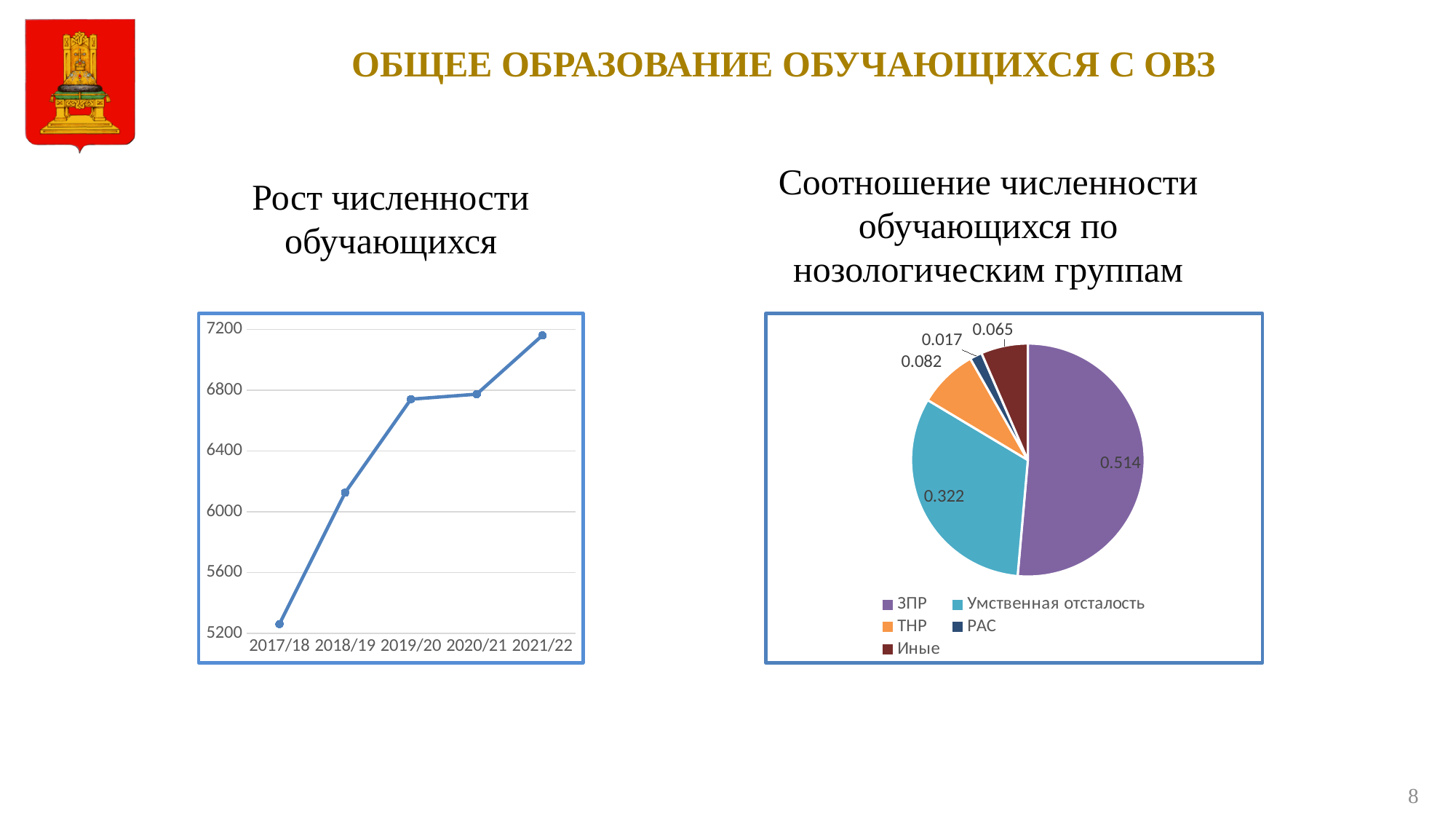
In the left chart "Рост численности обучающихся", is the value for 2017/18 greater or less than 5600? less In the right pie chart, what is the value for ЗПР? 0.514 What kind of chart is the left chart titled "Рост численности обучающихся"? line chart In the right pie chart, what is the value for Умственная отсталость? 0.322 How many groups does the legend of the right pie chart list? 5 In the left chart "Рост численности обучающихся", is the value for 2021/22 greater or less than 6800? greater In the left chart "Рост численности обучающихся", is the value for 2018/19 greater or less than 6000? greater In the right pie chart, what is the difference between the values for ЗПР and Умственная отсталость? 0.192 In the right pie chart, which group has the smallest share? РАС In the left chart "Рост численности обучающихся", do the values rise or fall from 2017/18 to 2021/22? rise What kind of chart is the right chart titled "Соотношение численности обучающихся по нозологическим группам"? pie chart In the left chart "Рост численности обучающихся", how many data points are plotted? 5